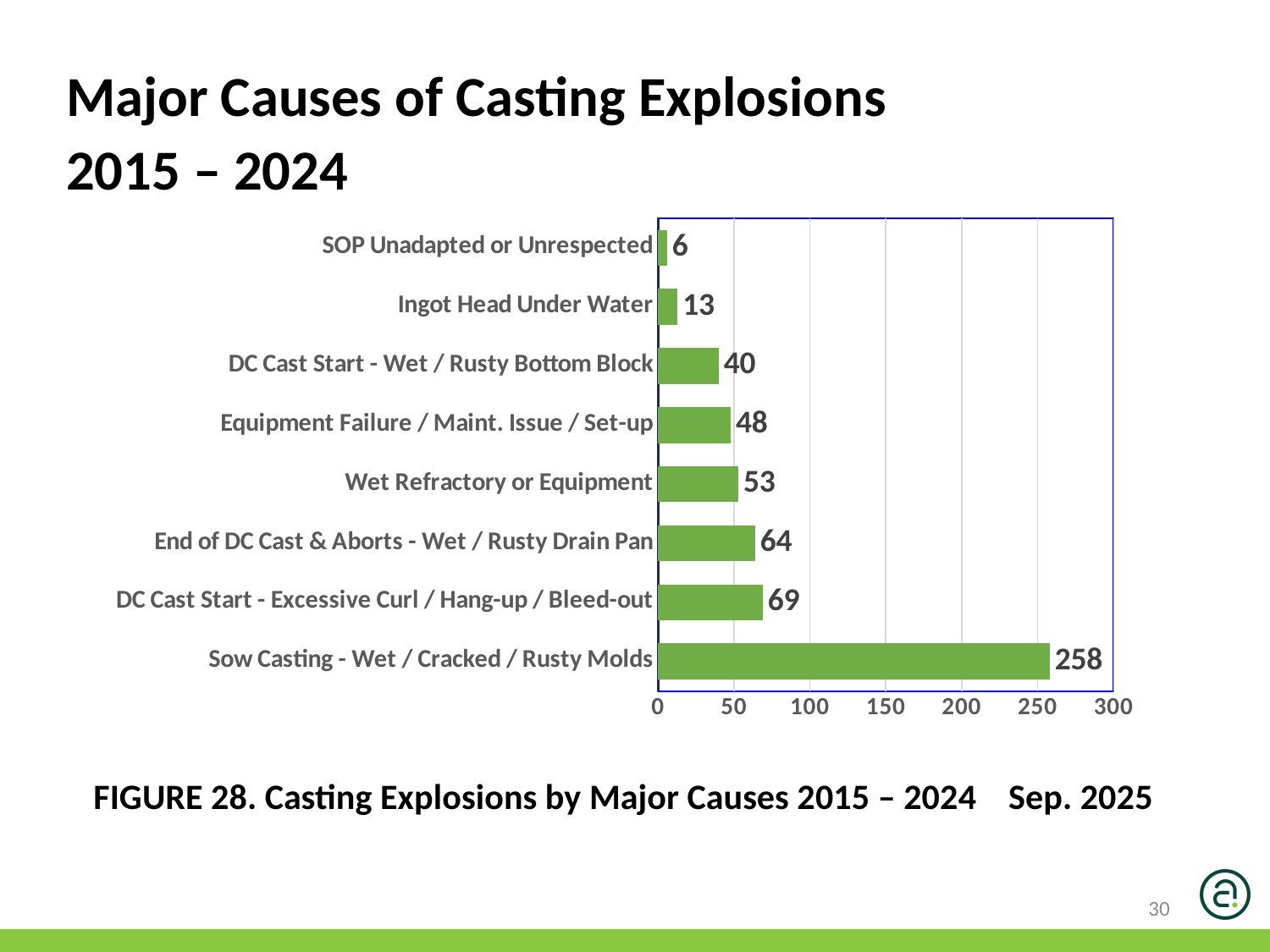
Which cause has the lowest number of casting explosions? SOP Unadapted or Unrespected Which cause has the highest number of casting explosions? Sow Casting - Wet / Cracked / Rusty Molds Is the value for Sow Casting - Wet / Cracked / Rusty Molds greater or less than 250? greater What is the value for Ingot Head Under Water? 13 What is the difference between the values for Sow Casting - Wet / Cracked / Rusty Molds and DC Cast Start - Excessive Curl / Hang-up / Bleed-out? 189 What is the value for Equipment Failure / Maint. Issue / Set-up? 48 What is the difference between the values for Wet Refractory or Equipment and DC Cast Start - Wet / Rusty Bottom Block? 13 What is the figure caption below the chart? FIGURE 28. Casting Explosions by Major Causes 2015 – 2024 Sep. 2025 How many causes are shown in the chart? 8 What is the value for Sow Casting - Wet / Cracked / Rusty Molds? 258 What kind of chart is shown on the slide? bar chart Which is larger, the value for End of DC Cast & Aborts - Wet / Rusty Drain Pan or the value for Wet Refractory or Equipment? End of DC Cast & Aborts - Wet / Rusty Drain Pan